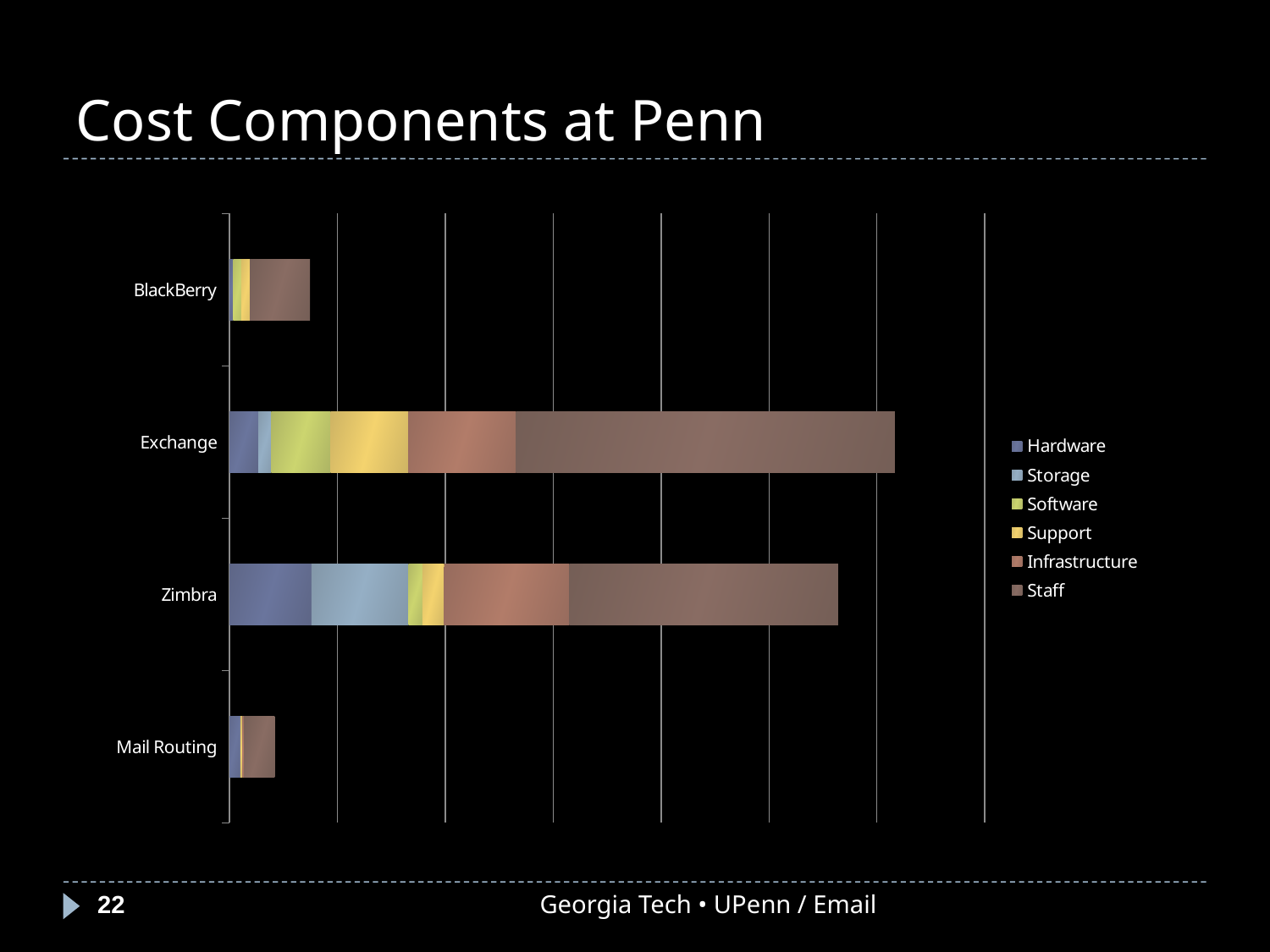
Which category has the larger Hardware segment, Exchange or Zimbra? Zimbra Which has the larger total bar, Zimbra or BlackBerry? Zimbra Which category has the larger Staff segment, Exchange or Zimbra? Exchange What is the title of the chart on the slide? Cost Components at Penn Which category has the shortest total bar? Mail Routing Which category has the longest total bar? Exchange What kind of chart is shown on the slide? Stacked bar chart Which series is listed first in the legend? Hardware How many series does the legend list? 6 How many categories are plotted on the chart? 4